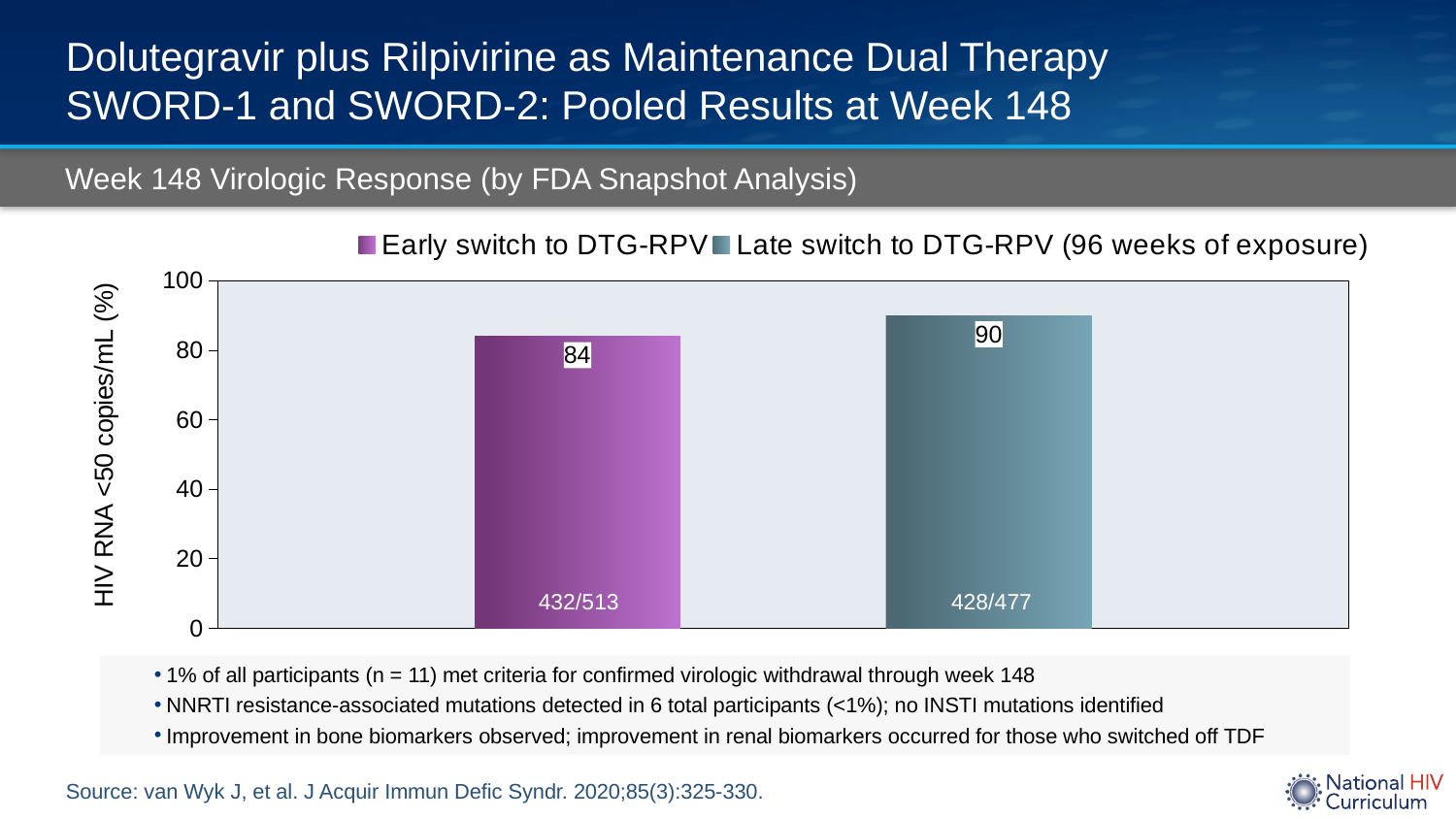
What is the value for Early switch to DTG-RPV? 84 Which series has the higher virologic response value? Late switch to DTG-RPV (96 weeks of exposure) What kind of chart is shown on the slide? bar chart What fraction is printed on the Early switch to DTG-RPV bar? 432/513 Is the value for Early switch to DTG-RPV larger or smaller than the value for Late switch to DTG-RPV? smaller Which series has the lower virologic response value? Early switch to DTG-RPV How many bars are plotted in the chart? 2 How many series does the legend list? 2 What is the y-axis label of the chart? HIV RNA <50 copies/mL (%) Is the value for Early switch to DTG-RPV greater or less than 80? greater What is the value for Late switch to DTG-RPV (96 weeks of exposure)? 90 What is the difference between the Late switch and Early switch values? 6